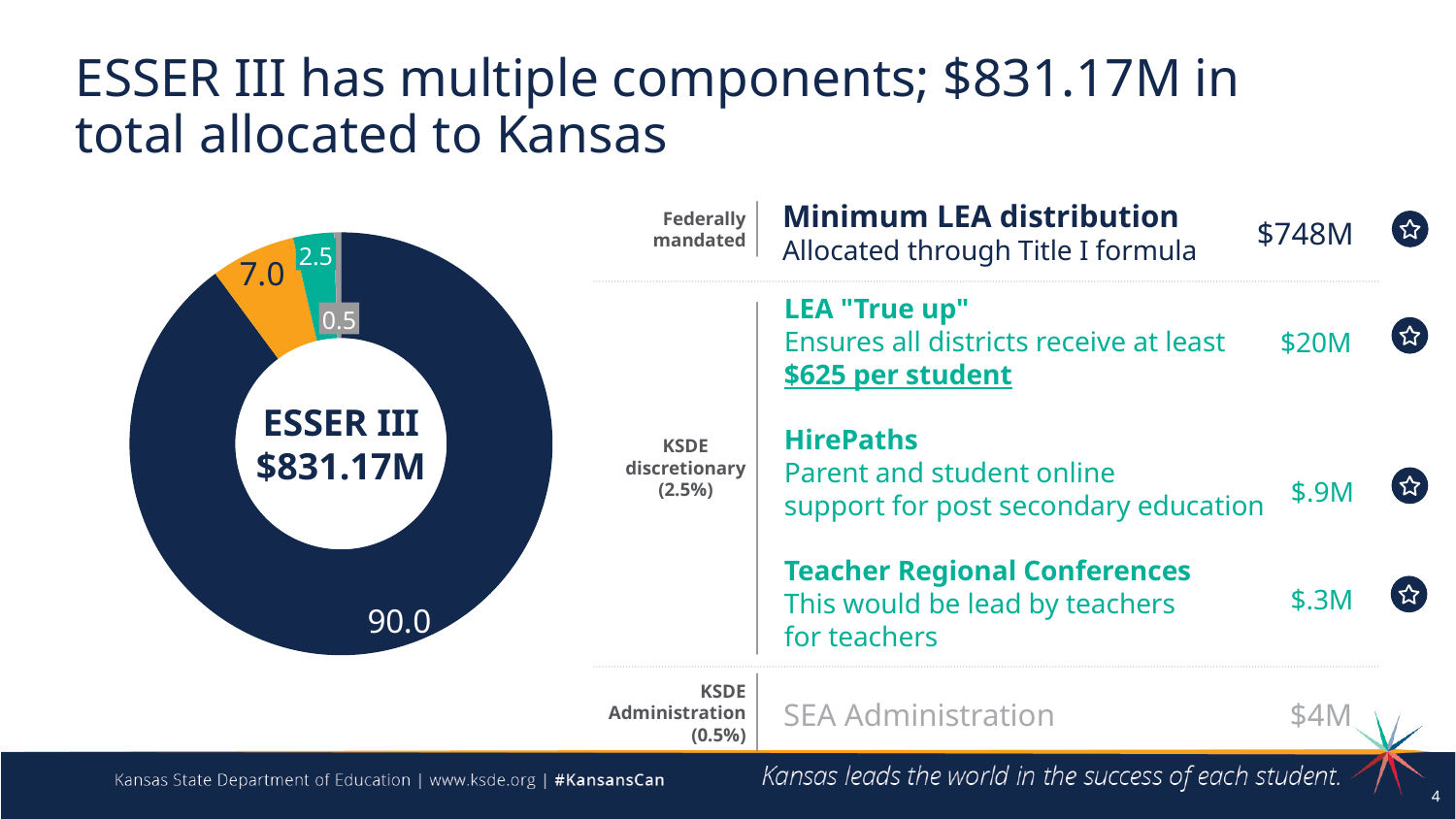
What is the value of the largest slice in the donut chart? 90.0 Which slice is larger in the donut chart, the orange slice or the green slice? the orange slice (7.0) What value is labeled on the orange slice of the donut chart? 7.0 How many slices does the donut chart have? 4 What value is labeled on the gray slice of the donut chart? 0.5 What is the difference between the largest slice (90.0) and the orange slice (7.0) in the donut chart? 83.0 What is the value of the smallest slice in the donut chart? 0.5 What total dollar amount is printed in the center of the donut chart? $831.17M What program name is printed in the center of the donut chart? ESSER III What kind of chart is shown on the left of the slide? pie chart (donut) What value is labeled on the dark navy slice of the donut chart? 90.0 What value is labeled on the green slice of the donut chart? 2.5